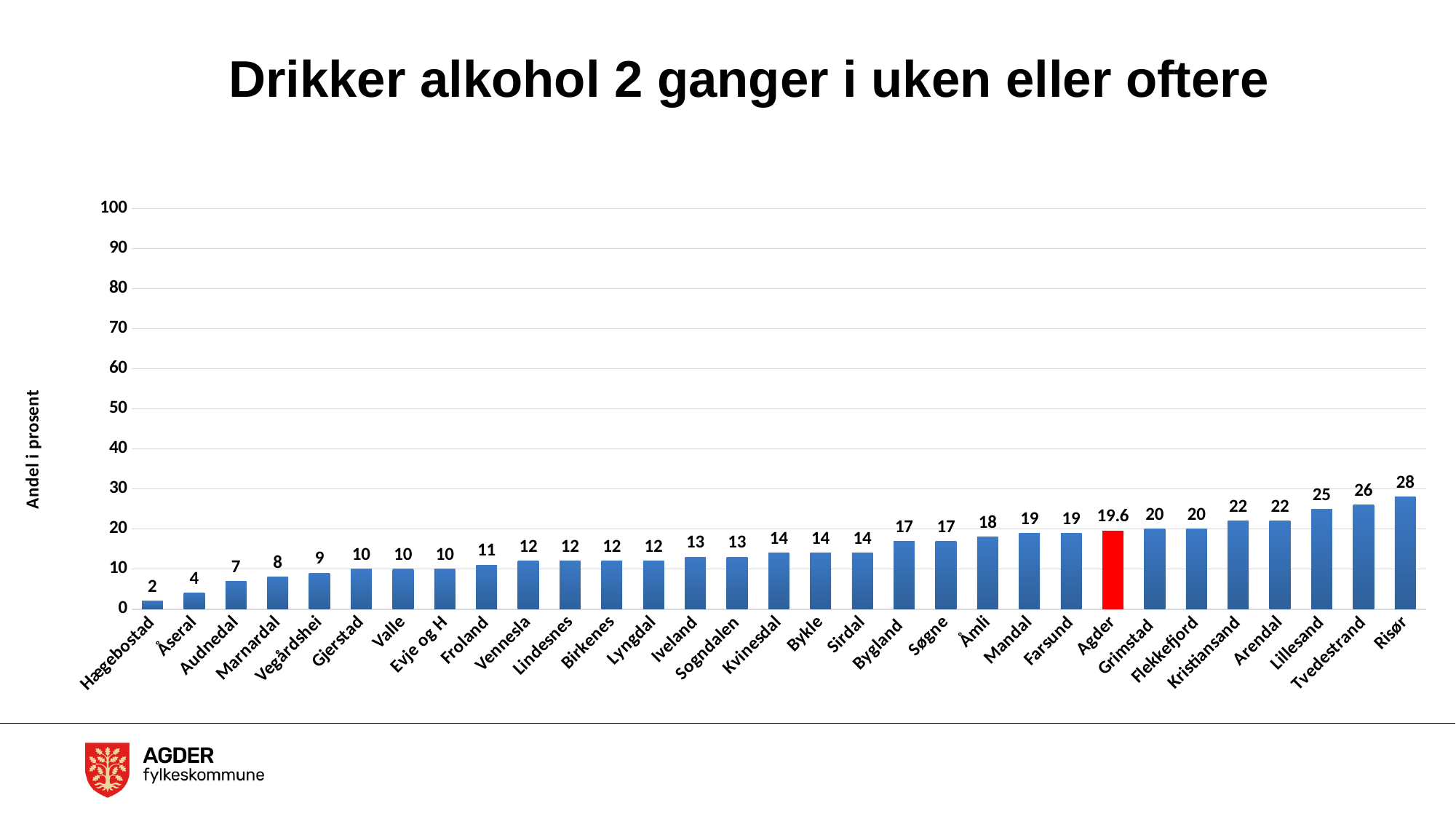
Which is larger, the value for Lillesand or the value for Grimstad? Lillesand What is the value for Agder? 19.6 Which bar is coloured red instead of blue? Agder Is the value for Tvedestrand greater or less than 20? greater What is the value for Hægebostad? 2 Which category has the highest value? Risør How many categories are shown on the x axis? 31 What is the value for Risør? 28 What kind of chart is shown on the slide? bar chart What is the difference between the values for Risør and Hægebostad? 26 Which category has the lowest value? Hægebostad What is the value for Kristiansand? 22